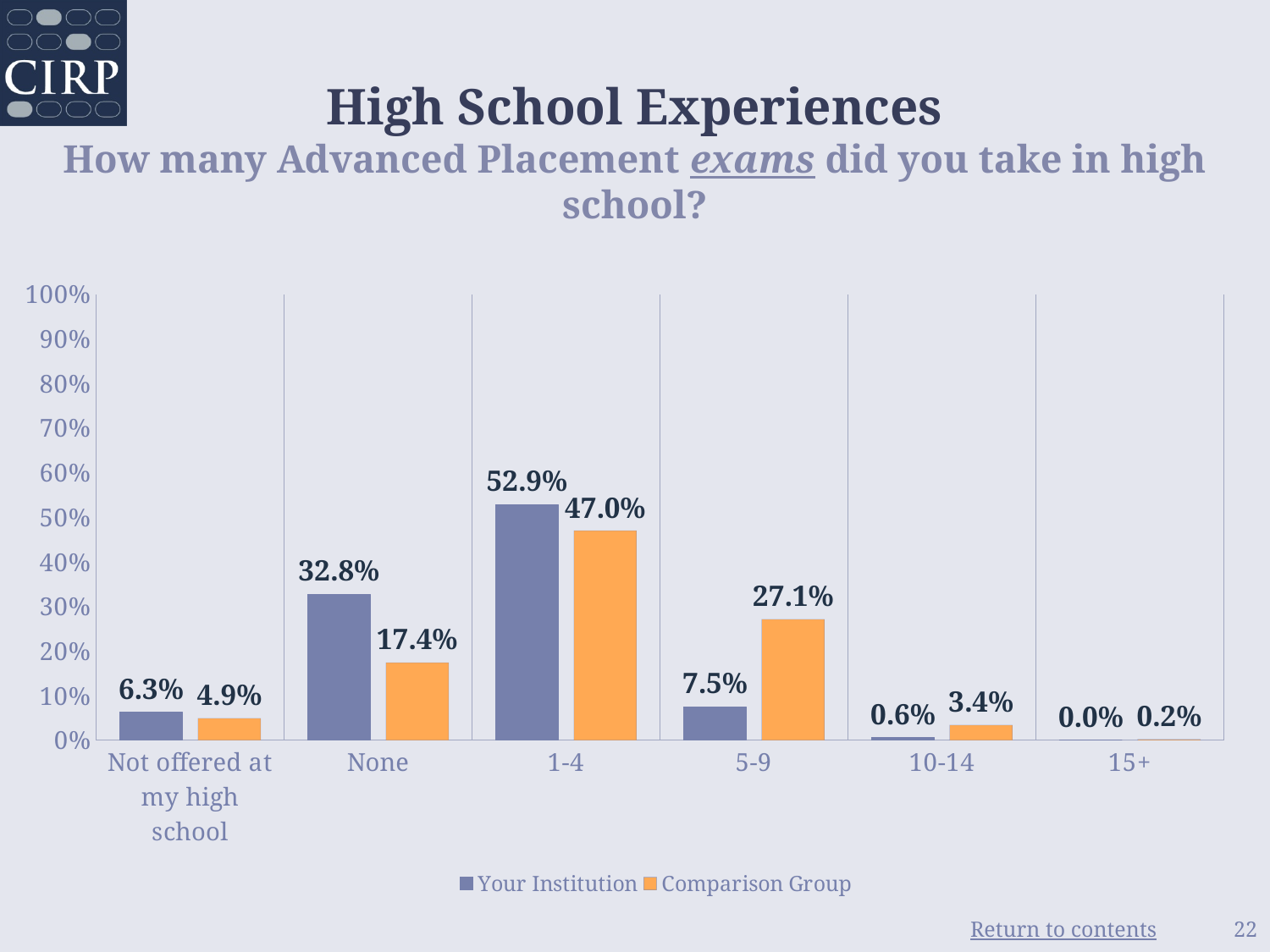
What kind of chart is shown on the slide? Bar chart How many categories are shown on the x axis? 6 What is the Comparison Group value for the 5-9 category? 27.1% How many series does the legend list? 2 Which category has the lowest value for Your Institution? 15+ Is the Your Institution value for 1-4 greater or less than 50%? greater What is the difference between Your Institution and the Comparison Group for the 'None' category? 15.4% What percentage of Your Institution respondents took 1-4 Advanced Placement exams? 52.9% What is the Comparison Group value for the 15+ category? 0.2% For the 5-9 category, which series has the larger value, Your Institution or the Comparison Group? Comparison Group What is the Your Institution value for the 'None' category? 32.8% Which category has the highest value for the Comparison Group? 1-4